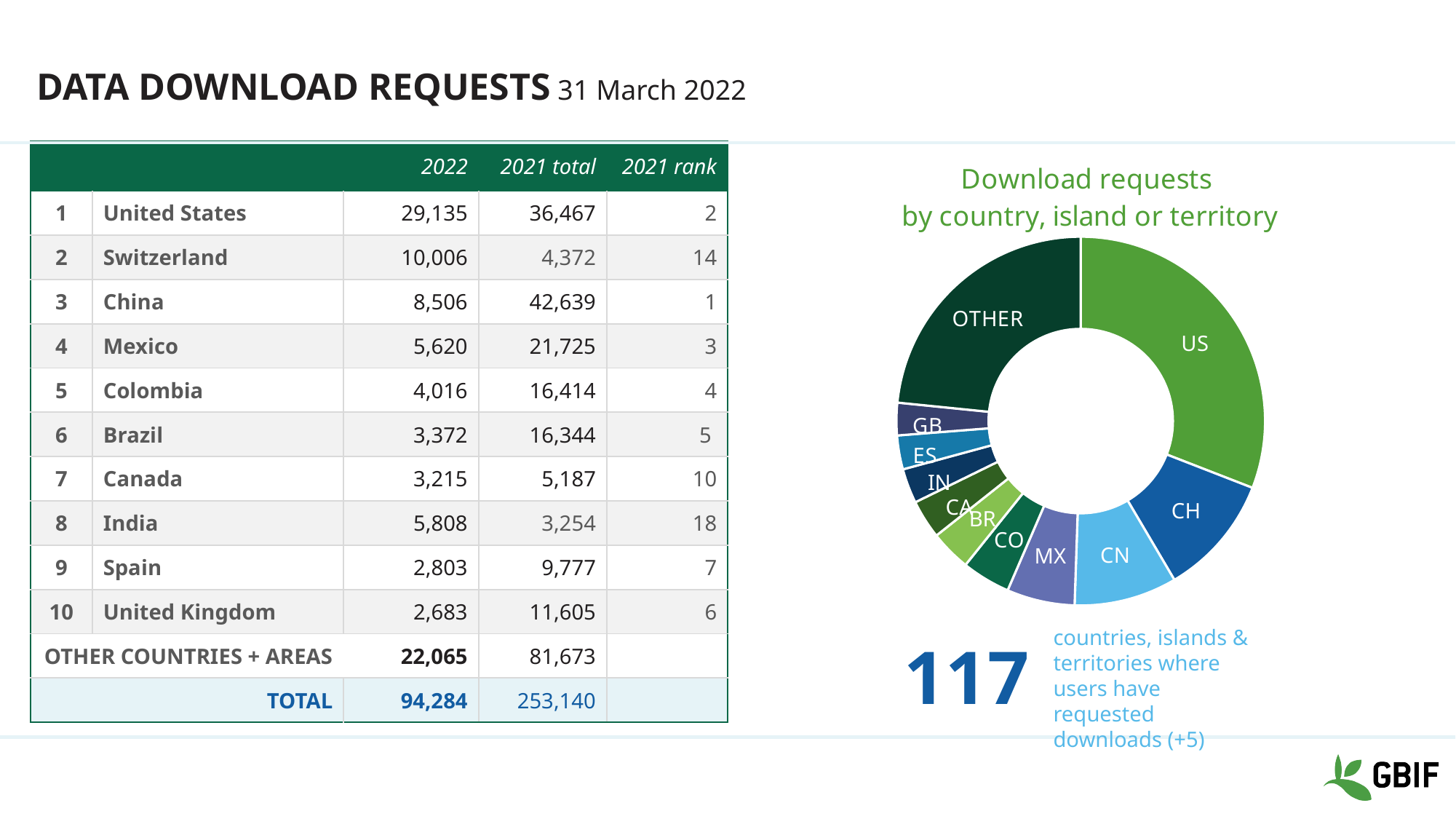
What is the difference between the 2022 download requests for the United States and China, as printed in the table? 20,629 In the donut chart, which slice is larger, MX or CO? MX What kind of chart is shown on the right of the slide? donut chart In the donut chart, which slice is larger, US or OTHER? US How many slices does the donut chart have? 11 According to the table, how many download requests did Switzerland (the CH slice) have in 2022? 10,006 According to the table, what is the 2022 value for the OTHER COUNTRIES + AREAS slice? 22,065 In the donut chart, which slice is larger, CH or CN? CH Which slice of the donut chart is the largest? US According to the table, how many download requests did the United States (the US slice) have in 2022? 29,135 What colour is the US slice in the donut chart? green What is the title of the donut chart? Download requests by country, island or territory